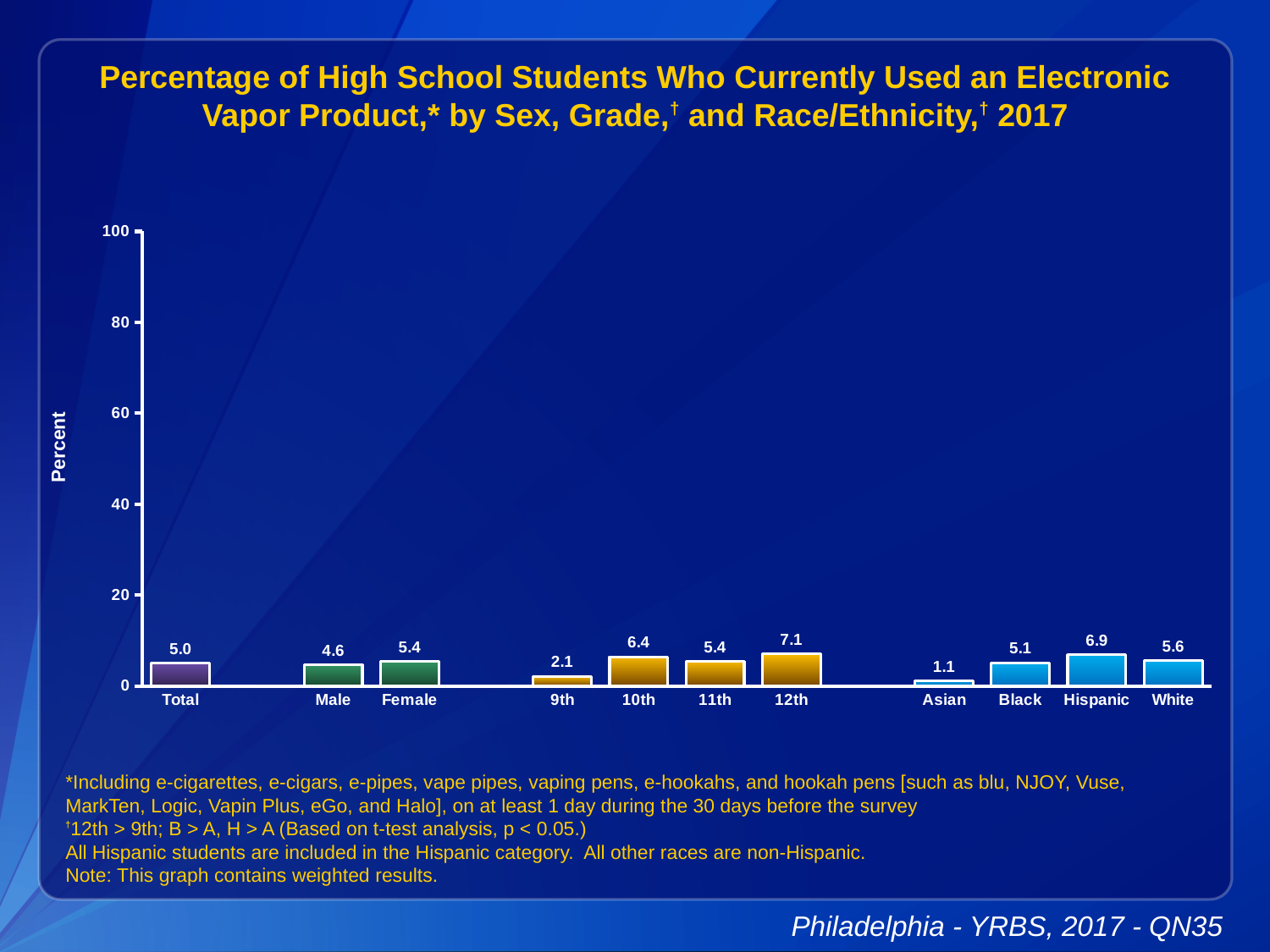
How many categories are shown on the x axis? 11 What is the value for Total? 5.0 Which category has the lowest value? Asian Which is larger, the value for Hispanic or the value for White? Hispanic What is the difference between the values for Female and Male? 0.8 Is the value for 10th grade greater or less than 20? less What is the value for Asian? 1.1 What is the value for Female? 5.4 What is the value for 9th grade? 2.1 What kind of chart is this? bar chart What is the difference between the values for 12th and 9th grade? 5.0 Which category has the highest value? 12th